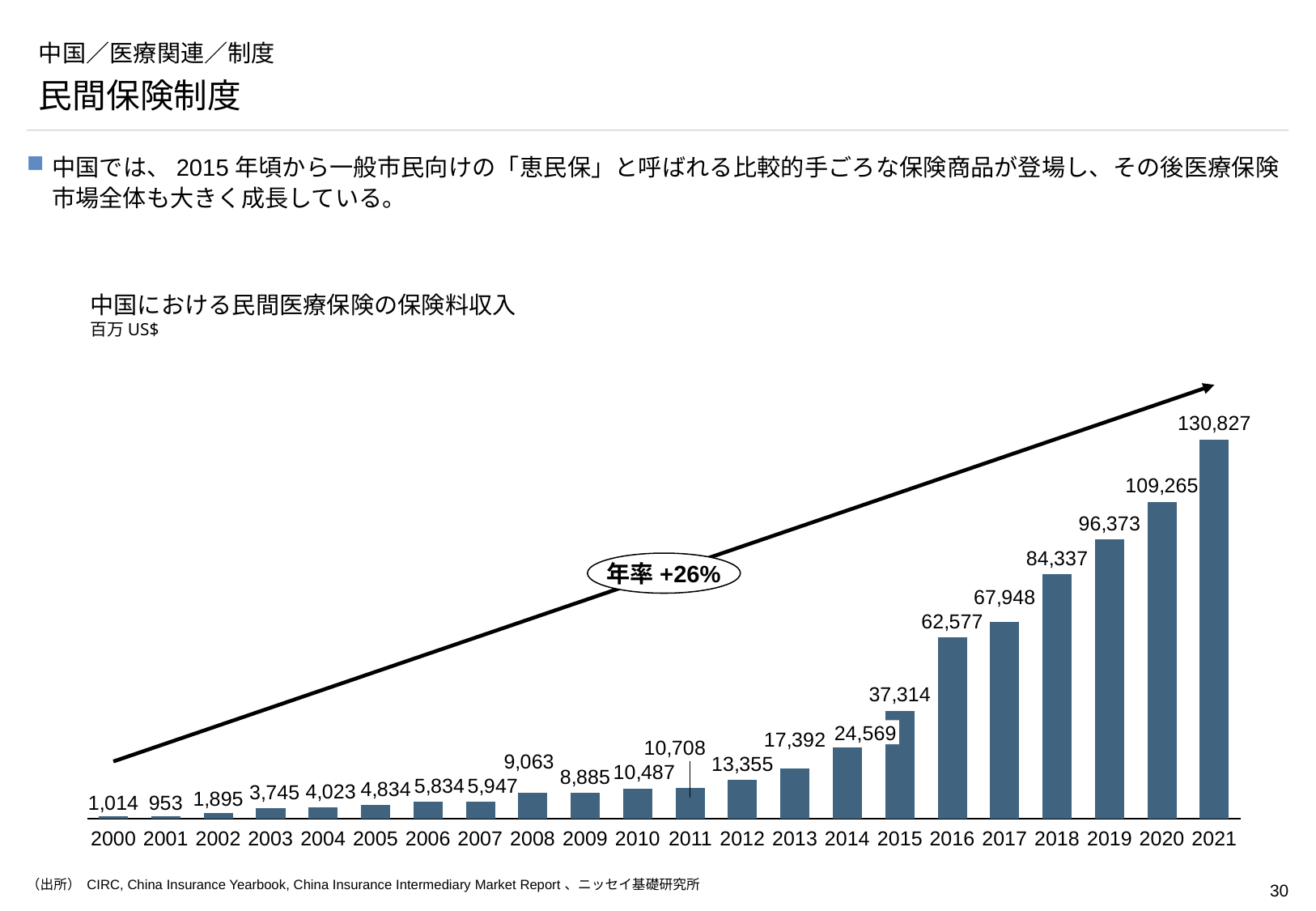
What is the value for 2021? 130,827 What annual growth rate is written in the oval annotation on the chart? 年率 +26% What kind of chart is this? Bar chart Which year has the highest value? 2021 What is the value for 2015? 37,314 What is the difference between the values for 2016 and 2015? 25,263 Do the values generally rise or fall from 2000 to 2021? Rise What is the value for 2008? 9,063 Which is larger, the value for 2008 or the value for 2009? 2008 What is the difference between the values for 2021 and 2020? 21,562 How many years are shown on the x axis? 22 Which year has the lowest value? 2001